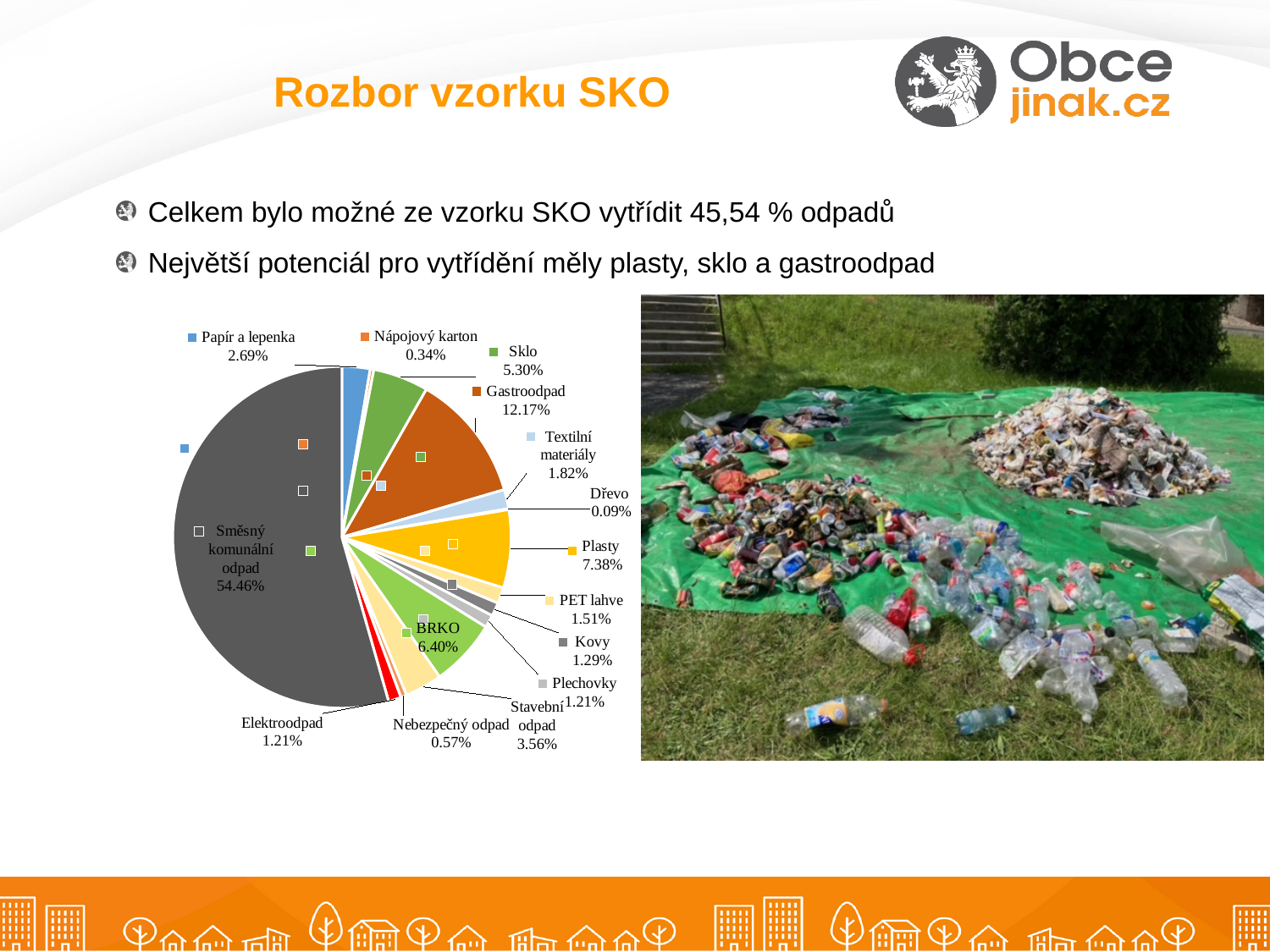
Which category has the largest share of the pie? Směsný komunální odpad Which is larger, Sklo or BRKO? BRKO What share of the pie does Směsný komunální odpad have? 54.46% How many categories does the pie chart show? 15 What is the value for Sklo? 5.30% What is the difference between the values for Gastroodpad and Plasty? 4.79% What is the value for BRKO? 6.40% Which category has the smallest share of the pie? Dřevo What kind of chart is shown on the slide? pie chart What is the value for Stavební odpad? 3.56% What is the value for Plasty? 7.38% What is the value for Gastroodpad? 12.17%